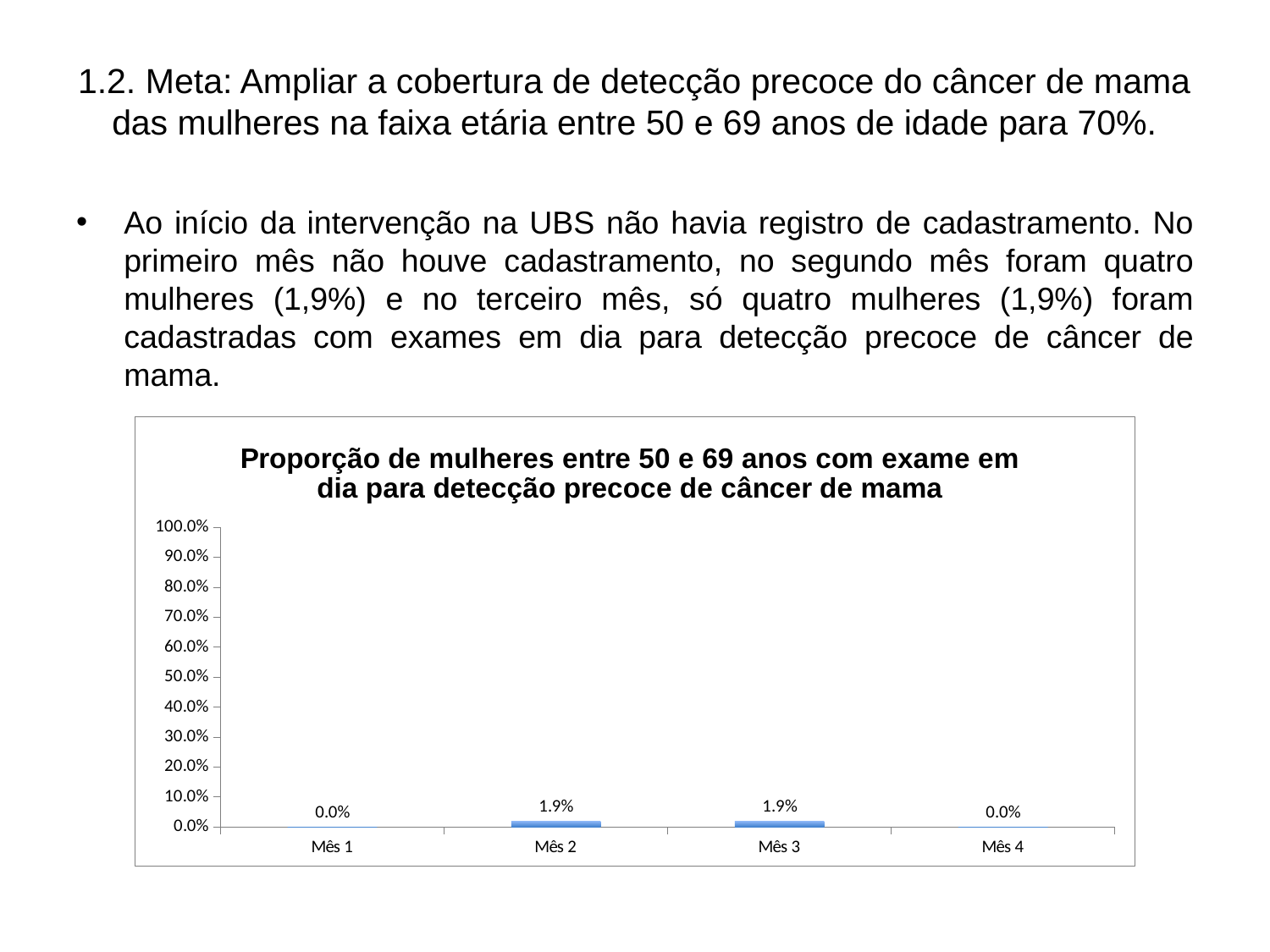
What is the title of the chart? Proporção de mulheres entre 50 e 69 anos com exame em dia para detecção precoce de câncer de mama What is the value for Mês 1? 0.0% What is the value for Mês 3? 1.9% What is the value for Mês 2? 1.9% What is the difference between the values for Mês 2 and Mês 1? 1.9% How many categories are shown on the x axis? 4 What is the value for Mês 4? 0.0% What kind of chart is shown on the slide? bar chart What is the highest value shown on the y axis? 100.0% Which is larger, the value for Mês 3 or the value for Mês 4? Mês 3 Is the value for Mês 2 greater or less than 10.0%? less Does the value rise or fall from Mês 3 to Mês 4? fall